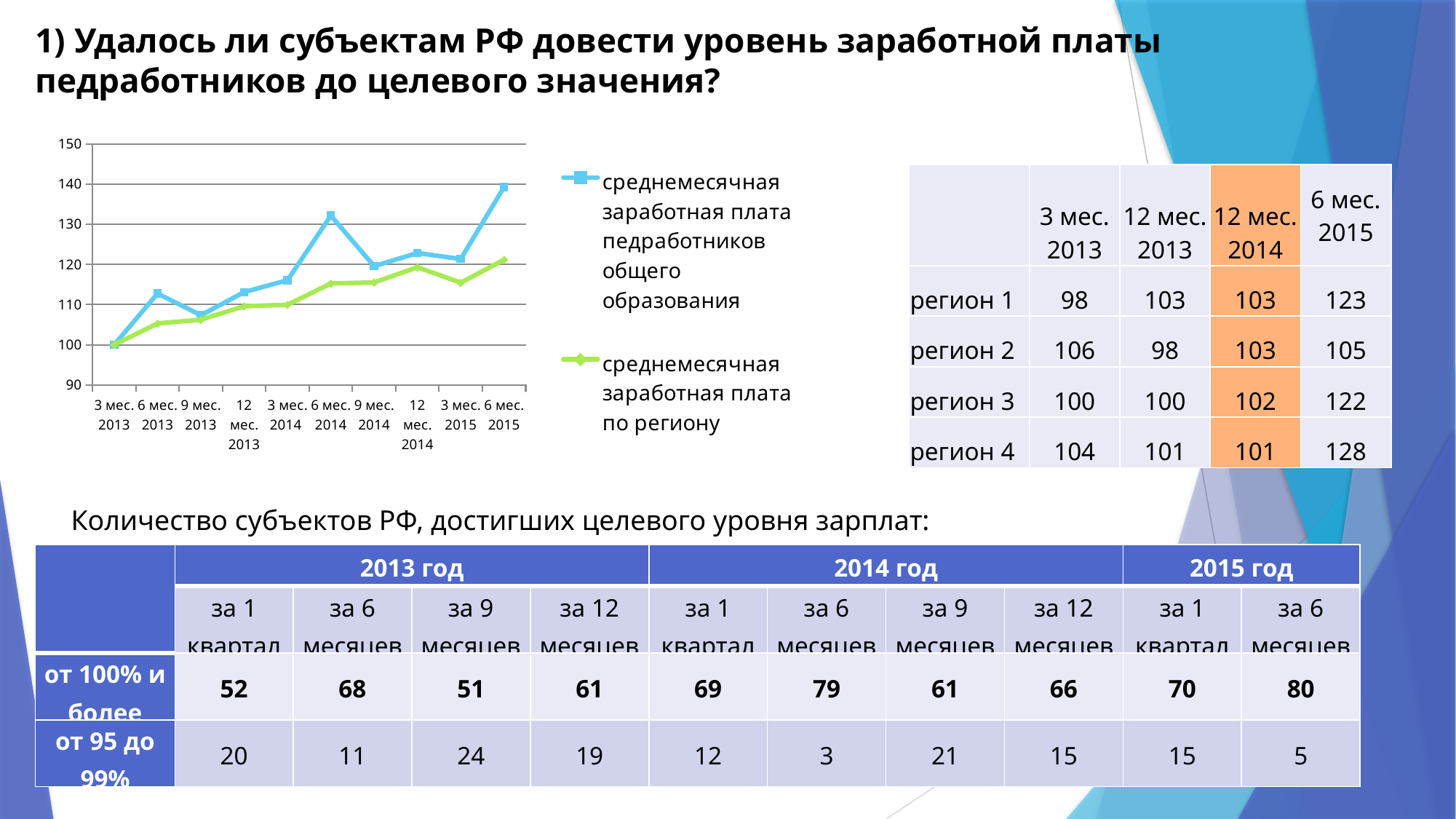
How many series does the chart's legend list? 2 What kind of chart is shown on the slide? line chart Which colour is used for the series 'среднемесячная заработная плата по региону' in the chart? green What is the value of the series 'среднемесячная заработная плата по региону' at 3 мес. 2013? 100 Does the series 'среднемесячная заработная плата по региону' generally rise or fall from 3 мес. 2013 to 6 мес. 2015? rise At 6 мес. 2014, which series has the higher value: 'среднемесячная заработная плата педработников общего образования' or 'среднемесячная заработная плата по региону'? среднемесячная заработная плата педработников общего образования At which x-axis point is the series 'среднемесячная заработная плата педработников общего образования' at its lowest value? 3 мес. 2013 Is the value for 'среднемесячная заработная плата по региону' at 6 мес. 2015 greater or less than 130? less Is the value for 'среднемесячная заработная плата педработников общего образования' at 6 мес. 2014 greater or less than 120? greater Is the value for 'среднемесячная заработная плата педработников общего образования' at 6 мес. 2015 greater or less than 130? greater How many points are plotted along the x axis of the chart? 10 At which x-axis point does the series 'среднемесячная заработная плата педработников общего образования' reach its highest value? 6 мес. 2015